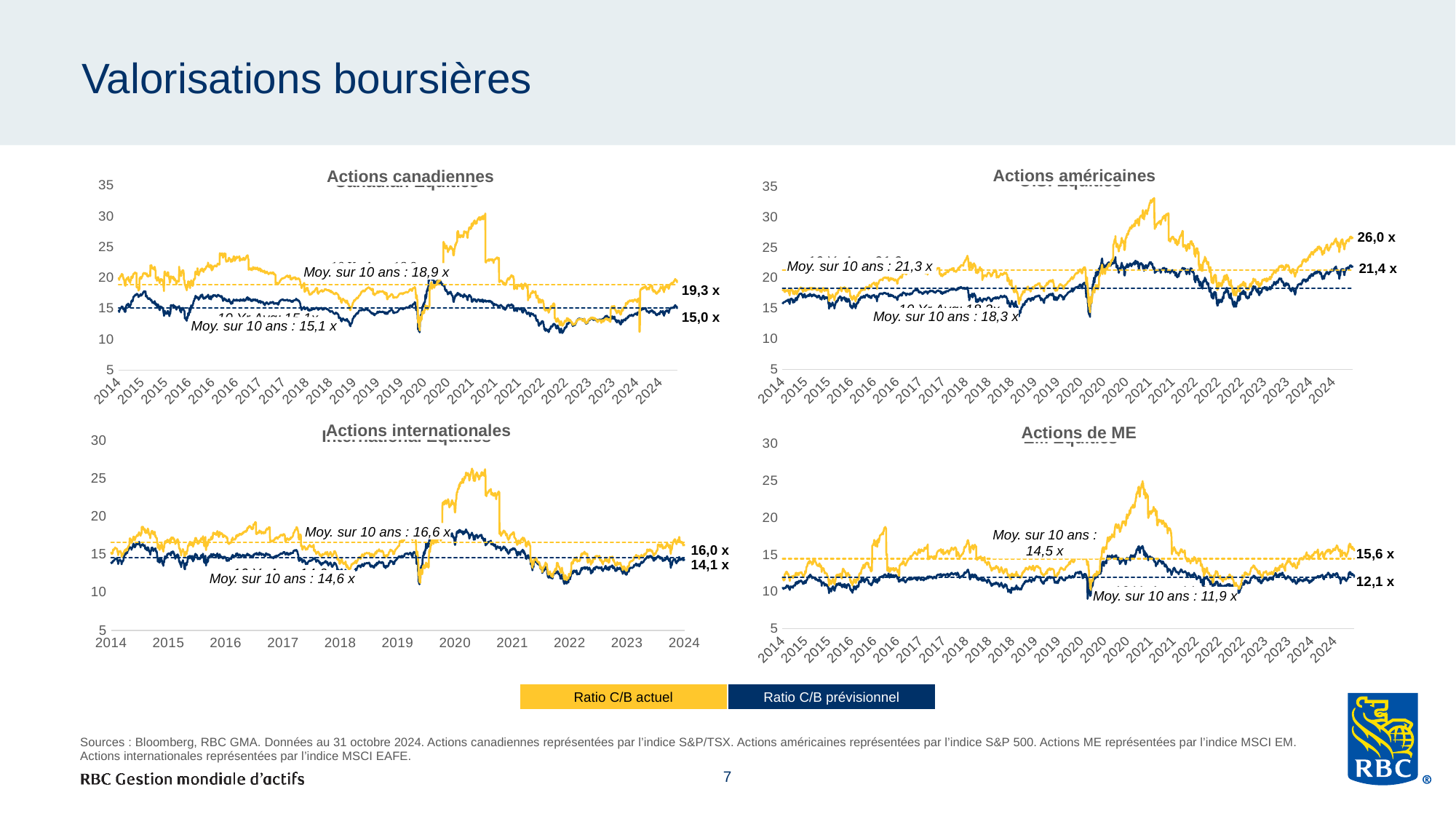
Which colour represents the Ratio C/B actuel in the legend? Yellow On the Actions internationales chart, what is the 10-year average (Moy. sur 10 ans) of the Ratio C/B prévisionnel? 14,6 x What kind of chart is used for the Actions canadiennes panel? Line chart How many series does the legend list? 2 On the Actions canadiennes chart, what is the latest value shown for the Ratio C/B actuel? 19,3 x On the Actions américaines chart, is the peak of the Ratio C/B actuel around 2021 greater or less than 30? greater On the Actions de ME chart, what is the difference between the latest Ratio C/B actuel (15,6 x) and the latest Ratio C/B prévisionnel (12,1 x)? 3,5 x On the Actions de ME chart, what is the 10-year average (Moy. sur 10 ans) of the Ratio C/B actuel? 14,5 x Across the four charts, which market has the highest latest Ratio C/B actuel? Actions américaines On the Actions internationales chart, which is larger: the latest Ratio C/B actuel (16,0 x) or its 10-year average (16,6 x)? The 10-year average (16,6 x) On the Actions américaines chart, what is the latest value shown for the Ratio C/B prévisionnel? 21,4 x On the Actions américaines chart, what is the difference between the latest Ratio C/B actuel (26,0 x) and the latest Ratio C/B prévisionnel (21,4 x)? 4,6 x